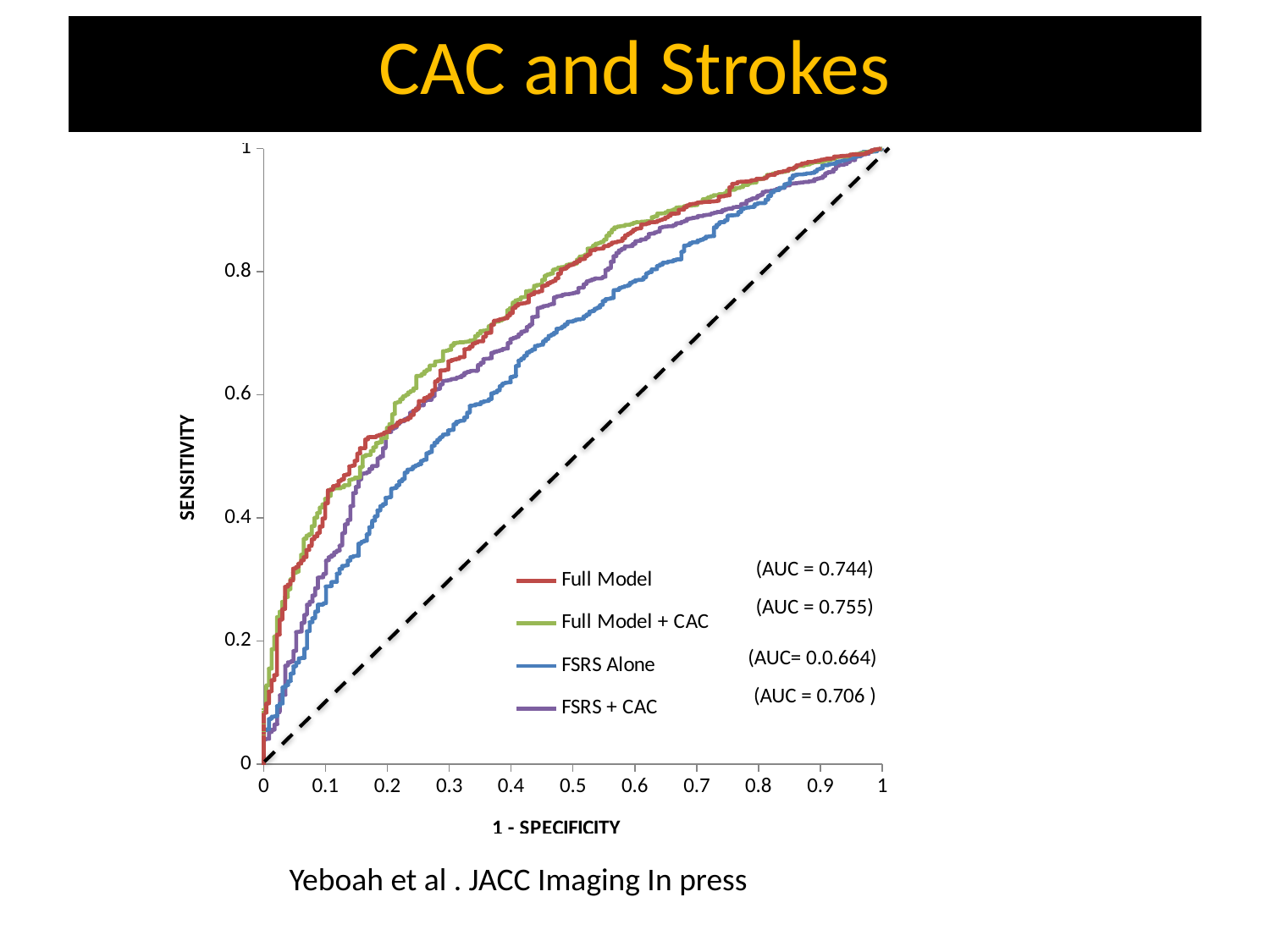
What is the difference between the AUC of Full Model + CAC and the AUC of the Full Model? 0.011 How many series does the legend list? 4 Which has a larger AUC, FSRS + CAC or the Full Model? Full Model What kind of chart is shown on the slide? line chart What is the AUC shown for the Full Model? 0.744 Which series has the lowest AUC? FSRS Alone Which series has the highest AUC? Full Model + CAC What is the AUC shown for Full Model + CAC? 0.755 What is the label of the y axis? SENSITIVITY Is the sensitivity of FSRS Alone at 1 - specificity of 0.5 greater or less than 0.8? less Do the curves rise or fall as 1 - specificity increases along the x axis? rise What is the AUC shown for FSRS + CAC? 0.706